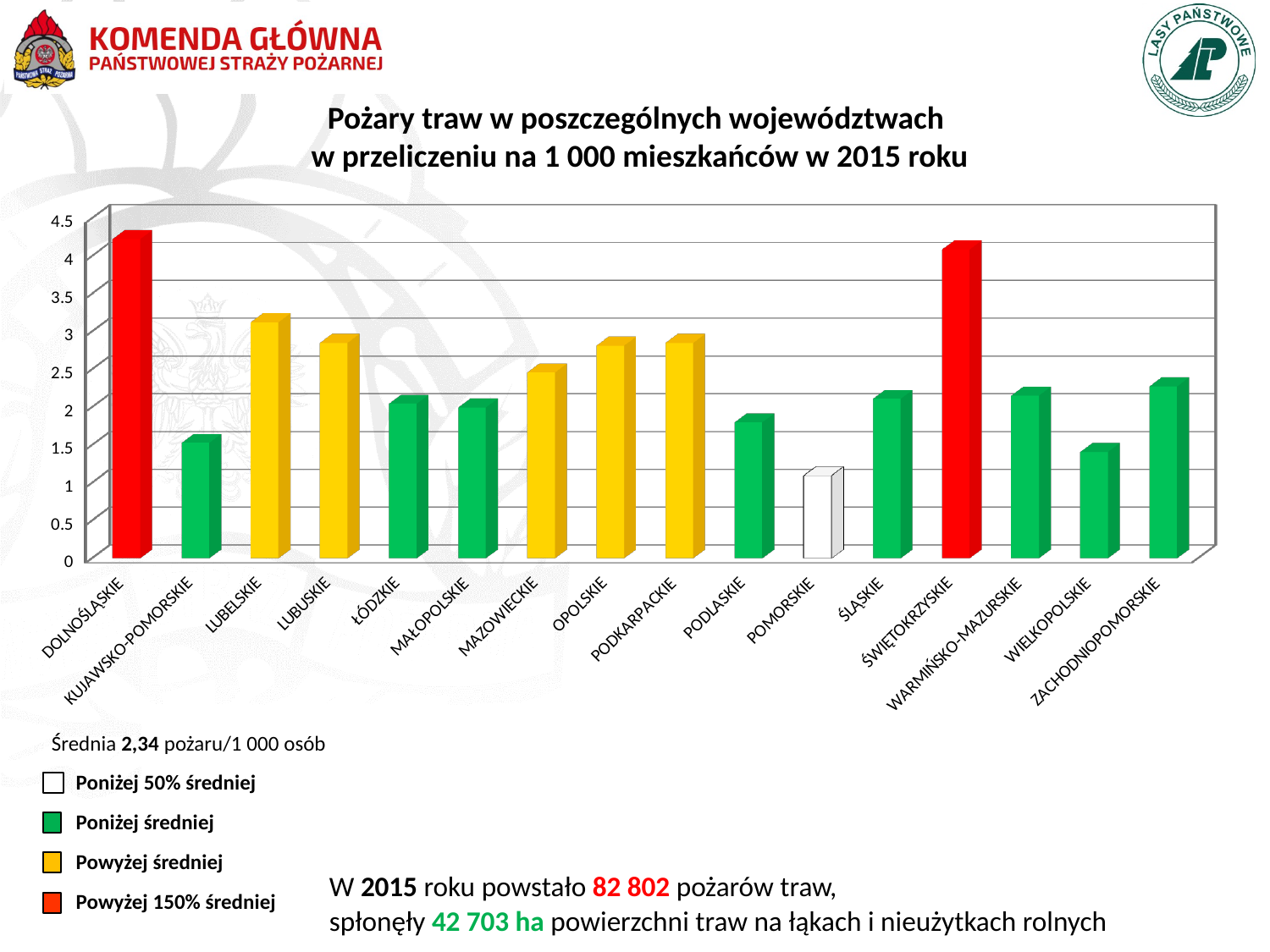
Is the value for LUBELSKIE greater or less than 3? greater Which has the larger value, LUBELSKIE or LUBUSKIE? LUBELSKIE Is the value for DOLNOŚLĄSKIE greater or less than 4? greater What kind of chart is shown on the slide? bar chart Is the value for KUJAWSKO-POMORSKIE greater or less than 2? less Which voivodeship has the highest value on the chart? DOLNOŚLĄSKIE How many voivodeships (categories) are plotted on the chart? 16 Which voivodeship has the lowest value on the chart? POMORSKIE What average value (Średnia) is stated below the chart? 2,34 pożaru/1 000 osób Which has the larger value, POMORSKIE or WIELKOPOLSKIE? WIELKOPOLSKIE